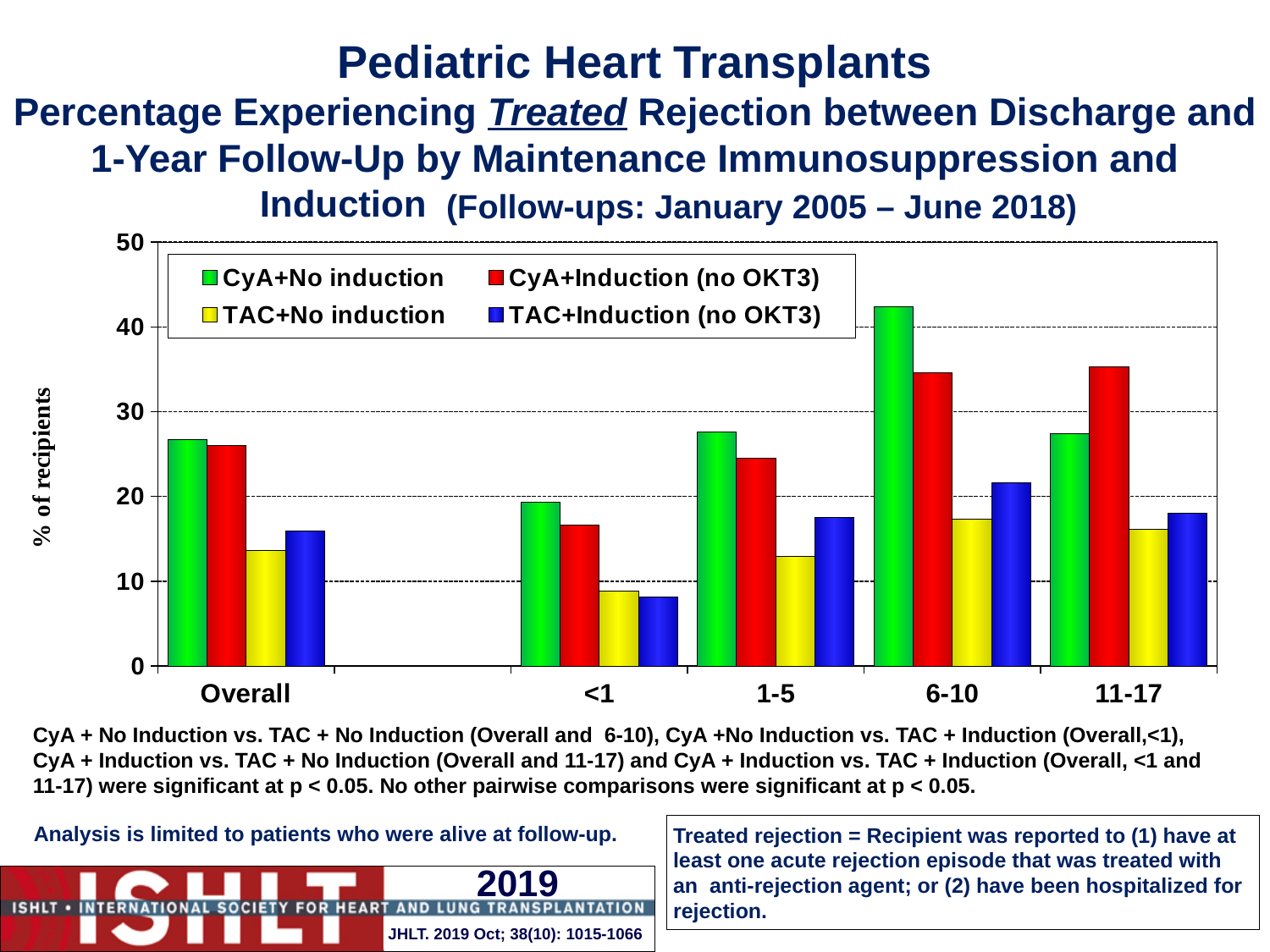
What is the label on the y axis of the chart? % of recipients In the 11-17 age group, which is larger: CyA+No induction or CyA+Induction (no OKT3)? CyA+Induction (no OKT3) Is the Overall value for CyA+No induction greater or less than 20? greater Which category has the lowest TAC+Induction (no OKT3) bar? <1 In the 6-10 age group, which is larger: TAC+No induction or TAC+Induction (no OKT3)? TAC+Induction (no OKT3) Is the TAC+No induction value for the <1 age group greater or less than 10? less Is the CyA+No induction value for the 6-10 age group greater or less than 40? greater Which category has the highest CyA+No induction bar? 6-10 How many categories are shown along the x axis? 5 What kind of chart is shown on the slide? bar chart How many series does the legend list? 4